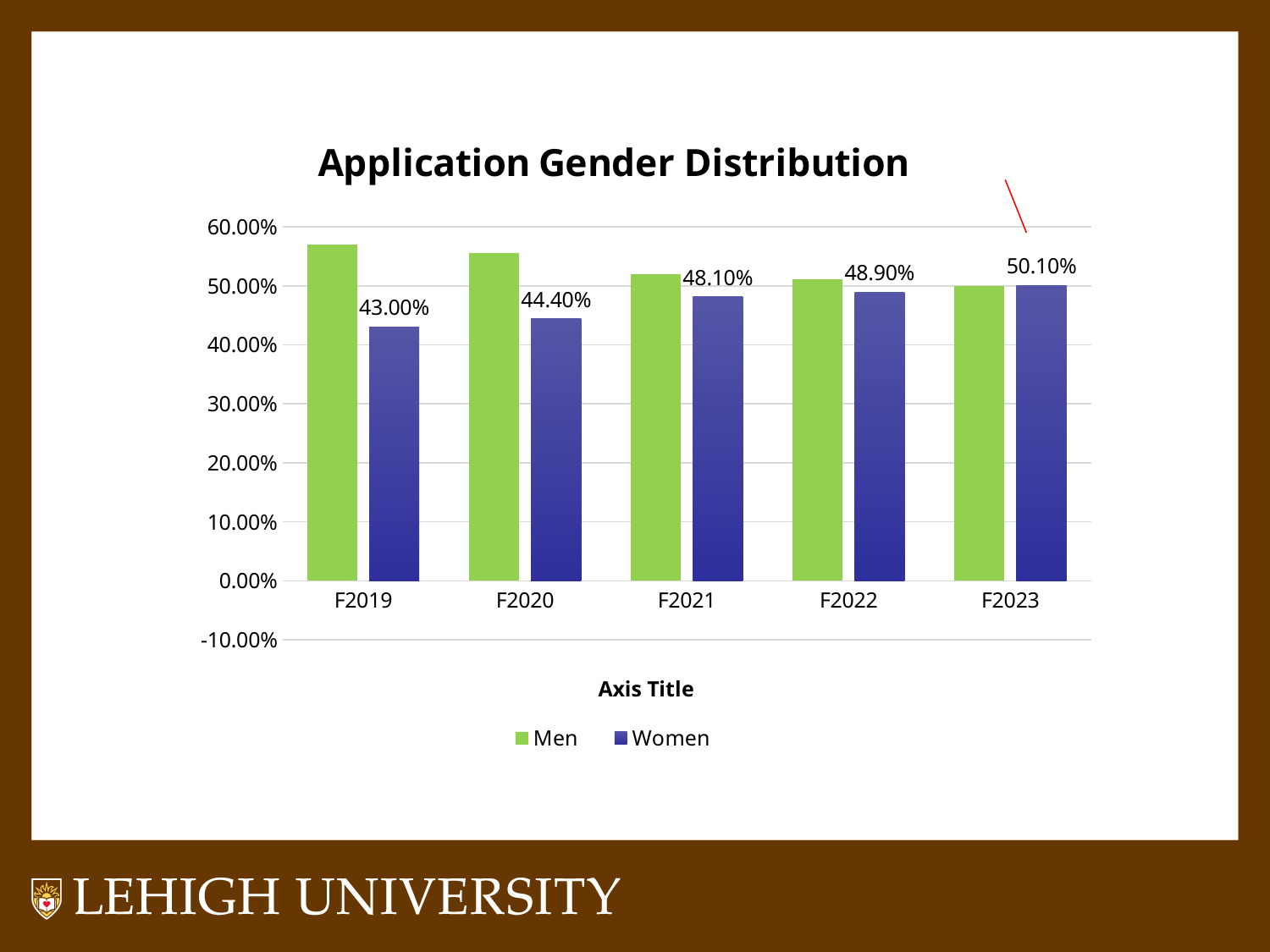
What is the value for Women in F2021? 48.10% In which year is the Women value lowest? F2019 Do the Women values rise or fall from F2019 to F2023? rise In which year is the Women value highest? F2023 Is the value for Men in F2019 greater or less than 50.00%? greater How many series does the legend list? 2 What kind of chart is shown? bar chart What is the value for Women in F2023? 50.10% In F2019, which is larger, the Men value or the Women value? Men What is the difference between the Women values for F2023 and F2019? 7.10% How many years are shown on the x axis? 5 What is the value for Women in F2019? 43.00%